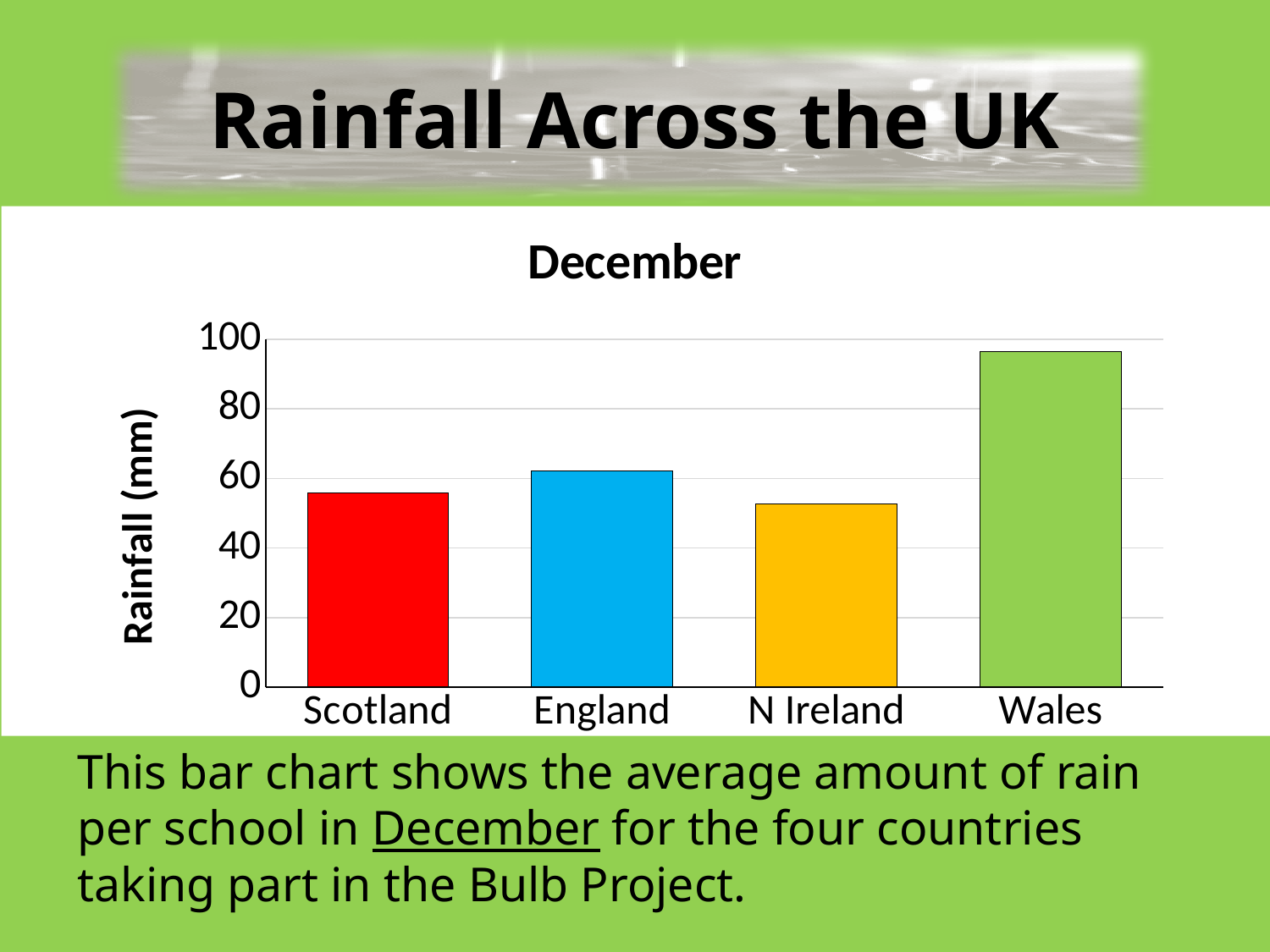
How many countries are shown on the chart? 4 Which country has the highest rainfall in the chart? Wales Is the rainfall value for Wales greater or less than 100? less Is the rainfall value for Wales greater or less than 80? greater Is the rainfall value for N Ireland greater or less than 40? greater Which has the higher rainfall, England or Scotland? England What kind of chart is shown on the slide? bar chart What is the label on the vertical axis of the chart? Rainfall (mm) Which has the higher rainfall, Wales or N Ireland? Wales What is the title of the chart? December